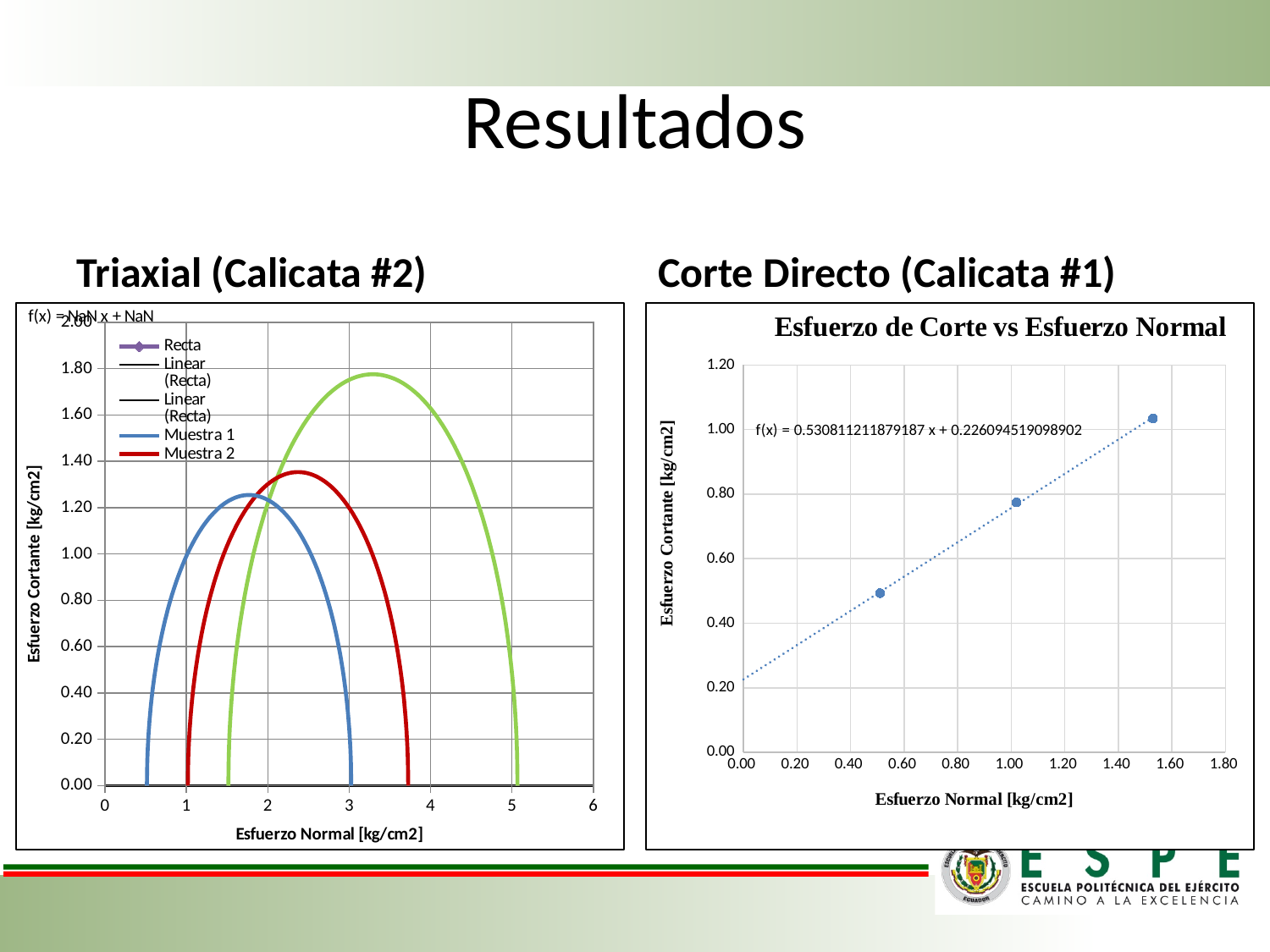
On the Triaxial (Calicata #2) chart, which reaches a higher peak, Muestra 1 or Muestra 2? Muestra 2 On the Corte Directo (Calicata #1) chart, is the Esfuerzo Cortante value of the point near Esfuerzo Normal 0.50 greater or less than 0.60? less On the Triaxial (Calicata #2) chart, is the peak of Muestra 1 greater or less than 1.40? less On the Triaxial (Calicata #2) chart, what is the title of the y axis? Esfuerzo Cortante [kg/cm2] On the Corte Directo (Calicata #1) chart, what is the slope in the displayed trendline equation? 0.530811211879187 What kind of chart is the Corte Directo (Calicata #1) chart? scatter chart On the Corte Directo (Calicata #1) chart, what is the intercept in the displayed trendline equation? 0.226094519098902 On the Corte Directo (Calicata #1) chart, do the values rise or fall as Esfuerzo Normal increases? rise On the Corte Directo (Calicata #1) chart, how many data points are plotted? 3 What is the title shown inside the Corte Directo (Calicata #1) chart? Esfuerzo de Corte vs Esfuerzo Normal On the Corte Directo (Calicata #1) chart, is the Esfuerzo Cortante value of the point near Esfuerzo Normal 1.00 greater or less than 0.60? greater On the Triaxial (Calicata #2) chart, how many entries does the legend list? 5